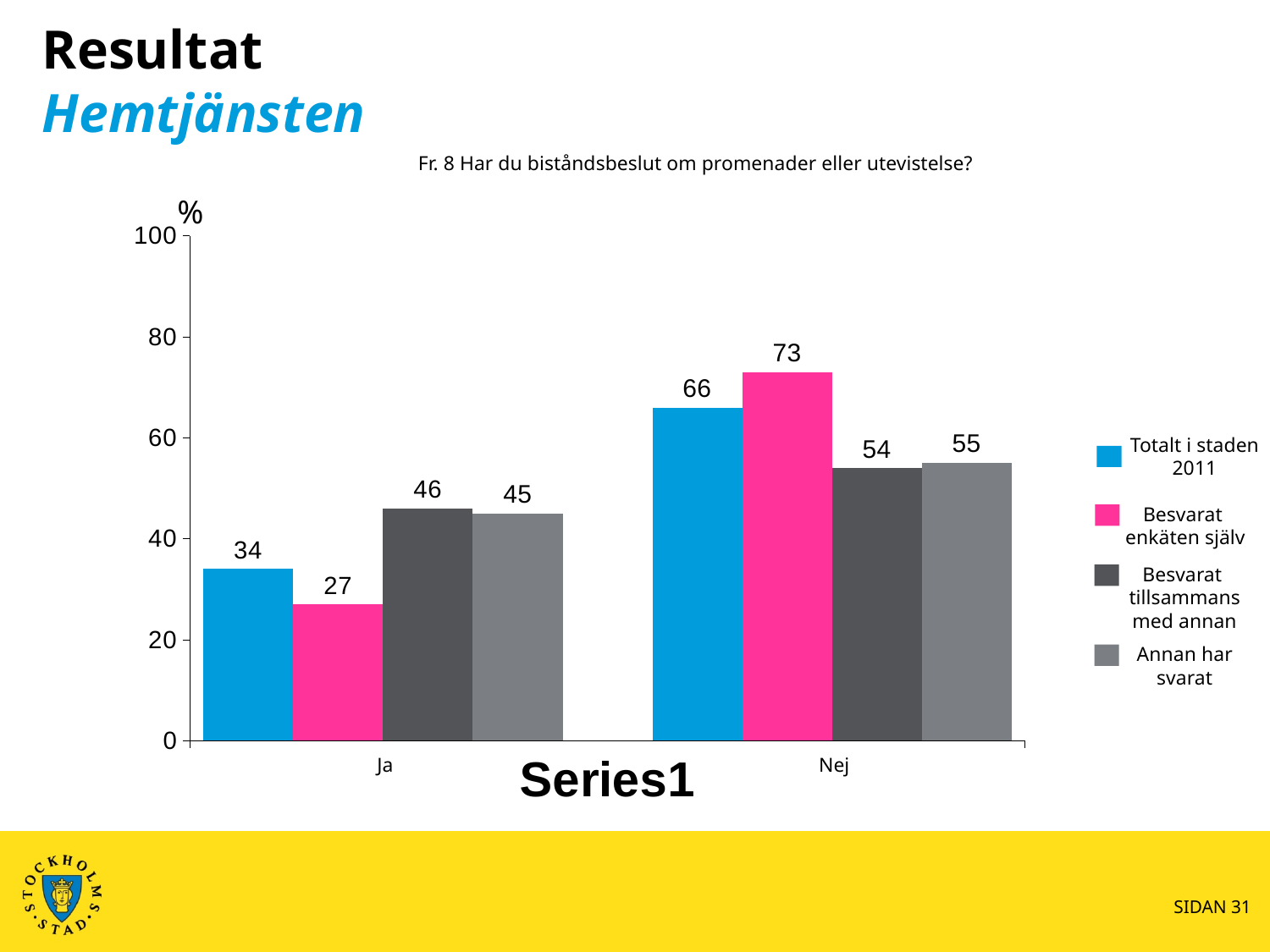
What is the value for 'Totalt i staden 2011' in the 'Ja' category? 34 What kind of chart is shown on the slide? Bar chart Which series has the highest value in the 'Nej' category? Besvarat enkäten själv What is the difference between the 'Nej' and 'Ja' values for 'Totalt i staden 2011'? 32 Is the 'Nej' value for 'Besvarat enkäten själv' greater or less than 60? greater What is the value for 'Besvarat enkäten själv' in the 'Nej' category? 73 Which is larger: the 'Ja' value for 'Besvarat tillsammans med annan' or the 'Ja' value for 'Totalt i staden 2011'? Besvarat tillsammans med annan What is the value for 'Besvarat tillsammans med annan' in the 'Nej' category? 54 What question is shown as the chart's title? Fr. 8 Har du biståndsbeslut om promenader eller utevistelse? Which series has the lowest value in the 'Ja' category? Besvarat enkäten själv What is the value for 'Annan har svarat' in the 'Ja' category? 45 How many series does the legend list? 4